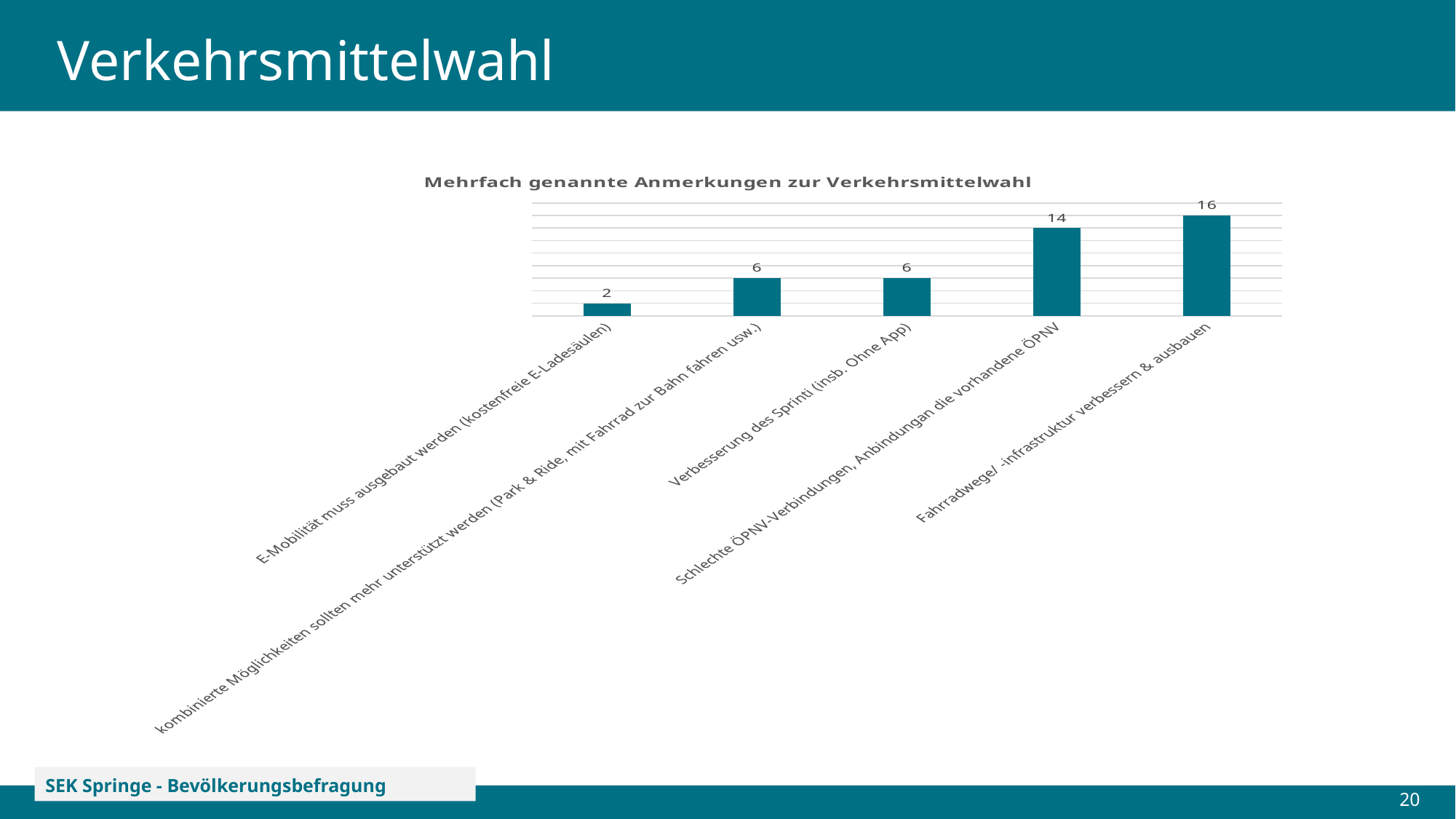
Which category has the highest value? Fahrradwege/ -infrastruktur verbessern & ausbauen What is the value for "Fahrradwege/ -infrastruktur verbessern & ausbauen"? 16 Which is larger: the value for "Schlechte ÖPNV-Verbindungen, Anbindungan die vorhandene ÖPNV" or the value for "Verbesserung des Sprinti (insb. Ohne App)"? Schlechte ÖPNV-Verbindungen, Anbindungan die vorhandene ÖPNV What is the difference between the values for "Fahrradwege/ -infrastruktur verbessern & ausbauen" and "Schlechte ÖPNV-Verbindungen, Anbindungan die vorhandene ÖPNV"? 2 What is the difference between the values for "Schlechte ÖPNV-Verbindungen, Anbindungan die vorhandene ÖPNV" and "E-Mobilität muss ausgebaut werden (kostenfreie E-Ladesäulen)"? 12 What is the value for "E-Mobilität muss ausgebaut werden (kostenfreie E-Ladesäulen)"? 2 What is the title of the chart? Mehrfach genannte Anmerkungen zur Verkehrsmittelwahl What is the value for "Verbesserung des Sprinti (insb. Ohne App)"? 6 Which category has the lowest value? E-Mobilität muss ausgebaut werden (kostenfreie E-Ladesäulen) What kind of chart is shown on the slide? Bar chart How many categories are shown in the chart? 5 What is the value for "Schlechte ÖPNV-Verbindungen, Anbindungan die vorhandene ÖPNV"? 14